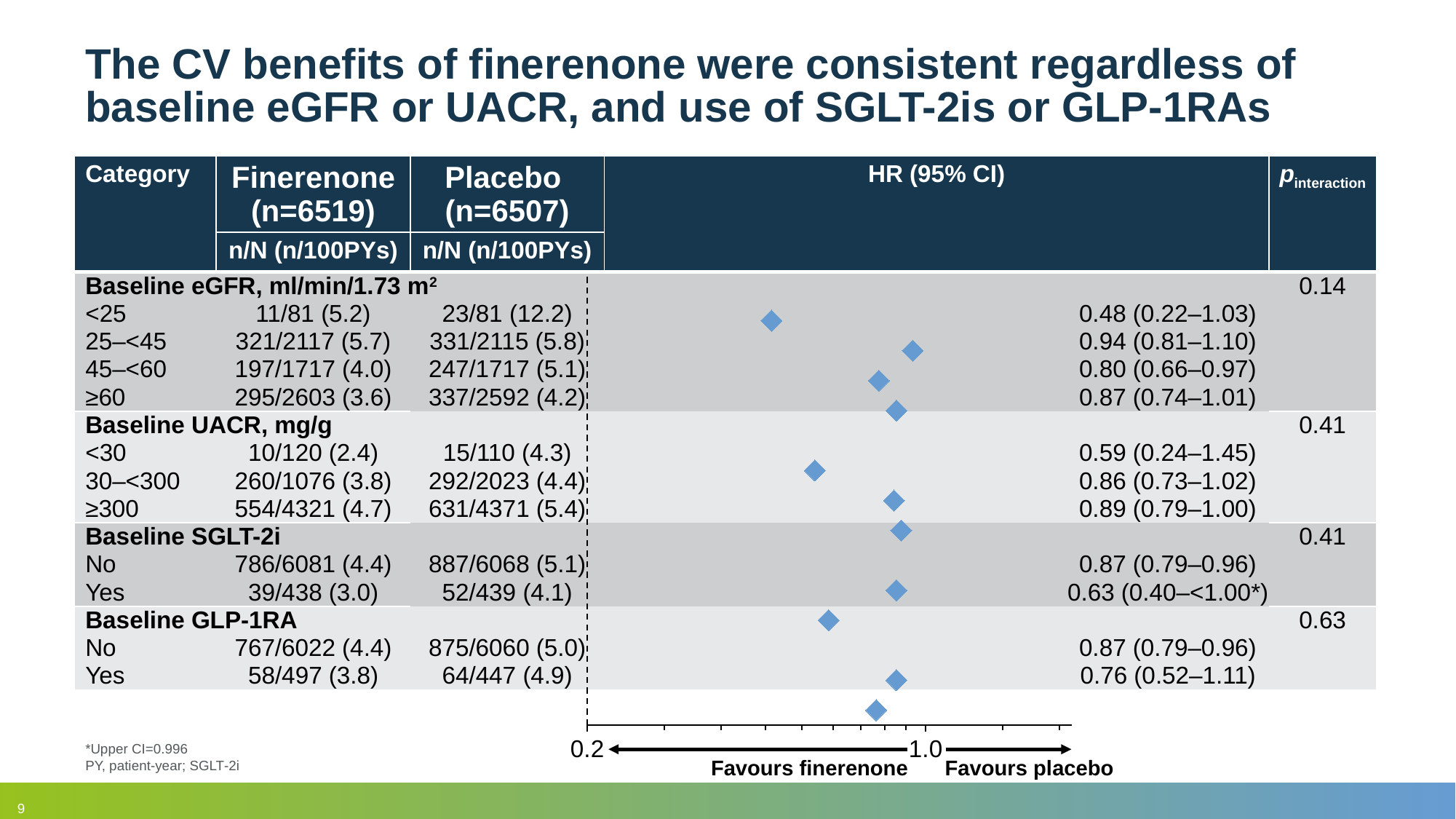
What label appears on the left side of the hazard ratio axis, below 1.0? Favours finerenone What is the difference between the hazard ratio for baseline SGLT-2i No (0.87) and baseline SGLT-2i Yes (0.63)? 0.24 How many subgroup hazard ratios are plotted in the forest plot? 11 Which baseline eGFR subgroup has the lowest hazard ratio? <25 Which has the lower hazard ratio: baseline SGLT-2i Yes or baseline SGLT-2i No? Yes What is the p-interaction value for the baseline UACR subgroups? 0.41 What is the HR (95% CI) for the baseline UACR <30 mg/g subgroup? 0.59 (0.24–1.45) Which baseline eGFR subgroup has the highest hazard ratio? 25–<45 Is the hazard ratio for the baseline eGFR <25 subgroup greater or less than 1.0? less What is the p-interaction value for the baseline GLP-1RA subgroups? 0.63 What is the HR (95% CI) for the baseline eGFR <25 subgroup? 0.48 (0.22–1.03) What kind of chart is shown on the slide? Forest plot